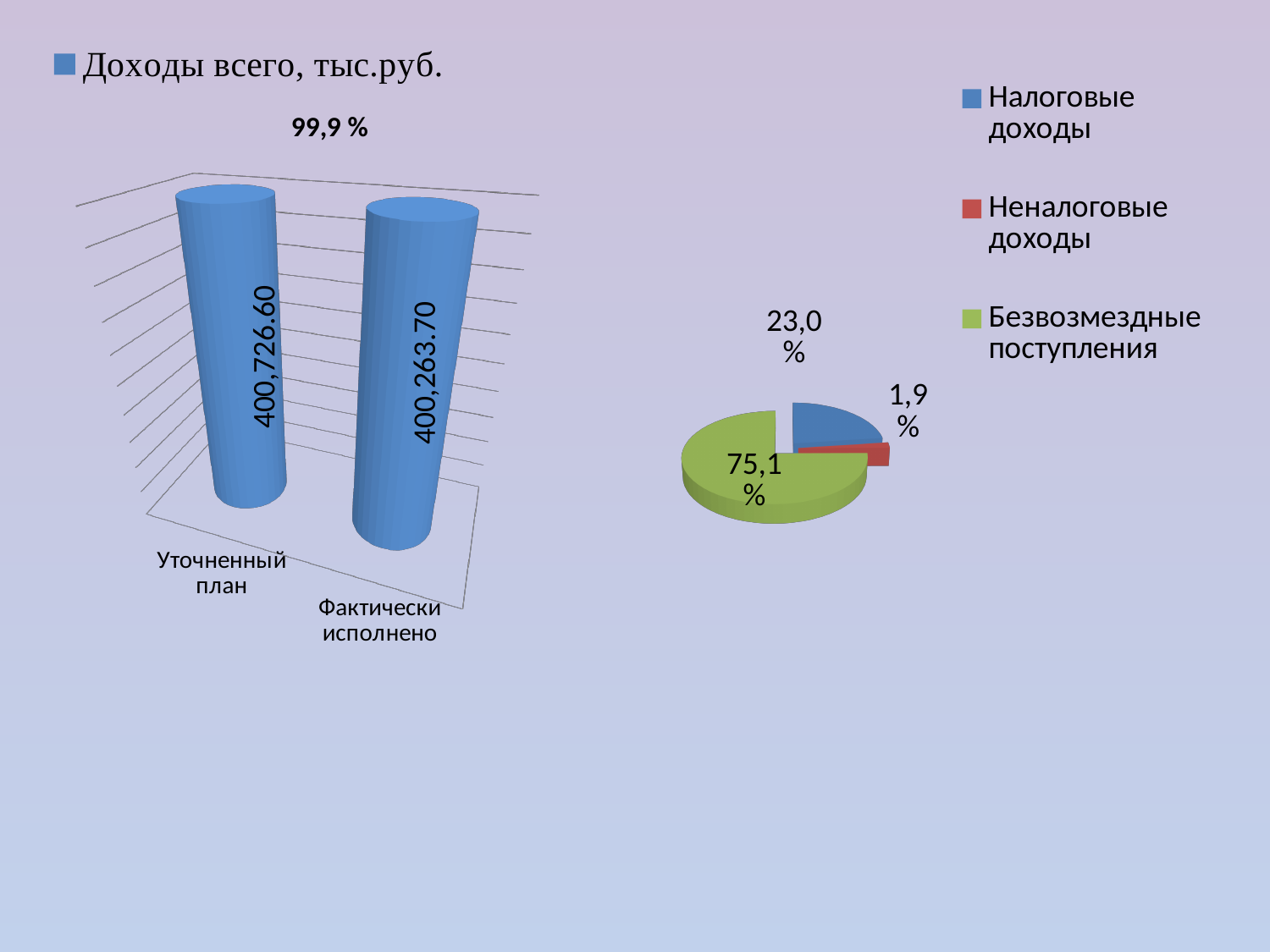
In the pie chart on the right, what share does 'Налоговые доходы' have? 23,0 % In the pie chart on the right, which category has the largest slice? Безвозмездные поступления In the pie chart on the right, what share does 'Безвозмездные поступления' have? 75,1 % In the left chart titled 'Доходы всего, тыс.руб.', which category has the lower value? Фактически исполнено In the left chart titled 'Доходы всего, тыс.руб.', what is the value for 'Уточненный план'? 400,726.60 In the left chart titled 'Доходы всего, тыс.руб.', what is the value for 'Фактически исполнено'? 400,263.70 In the left chart titled 'Доходы всего, тыс.руб.', how many bars are plotted? 2 In the left chart titled 'Доходы всего, тыс.руб.', which category has the higher value? Уточненный план In the pie chart on the right, what share does 'Неналоговые доходы' have? 1,9 % What kind of chart is the left chart titled 'Доходы всего, тыс.руб.'? Bar chart In the left chart titled 'Доходы всего, тыс.руб.', what is the difference between 'Уточненный план' and 'Фактически исполнено'? 462.90 In the pie chart on the right, how many entries does the legend list? 3